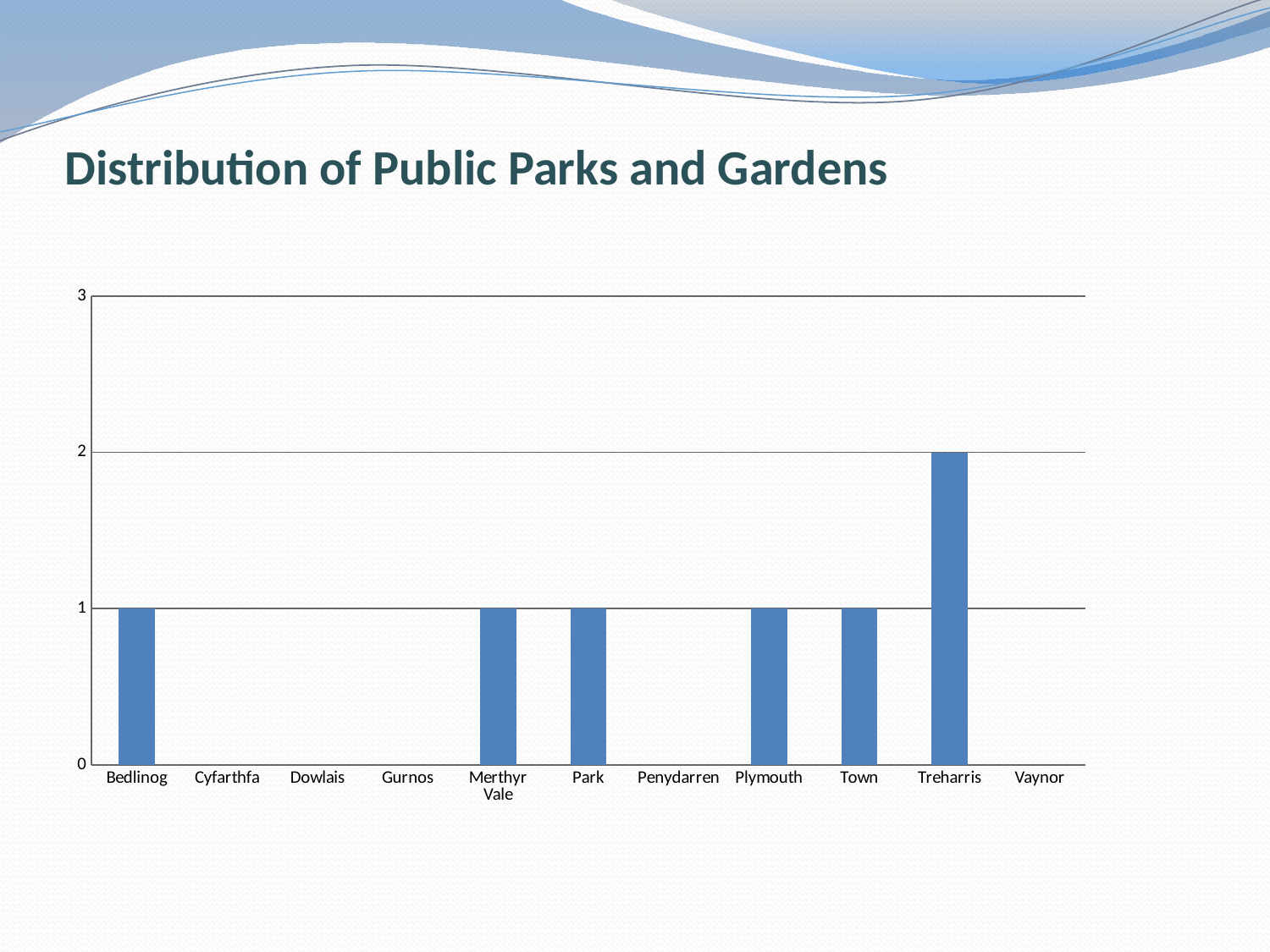
What is the value for Bedlinog? 1 What is the value for Treharris? 2 Is the value for Treharris greater or less than 1? greater Which category has the highest value? Treharris What is the title of the chart? Distribution of Public Parks and Gardens What kind of chart is shown on the slide? bar chart What is the value for Plymouth? 1 What is the difference between the values for Treharris and Town? 1 How many categories have a value of 1? 5 Which is larger, the value for Treharris or the value for Park? Treharris What is the value for Cyfarthfa? 0 How many categories are shown on the x axis? 11